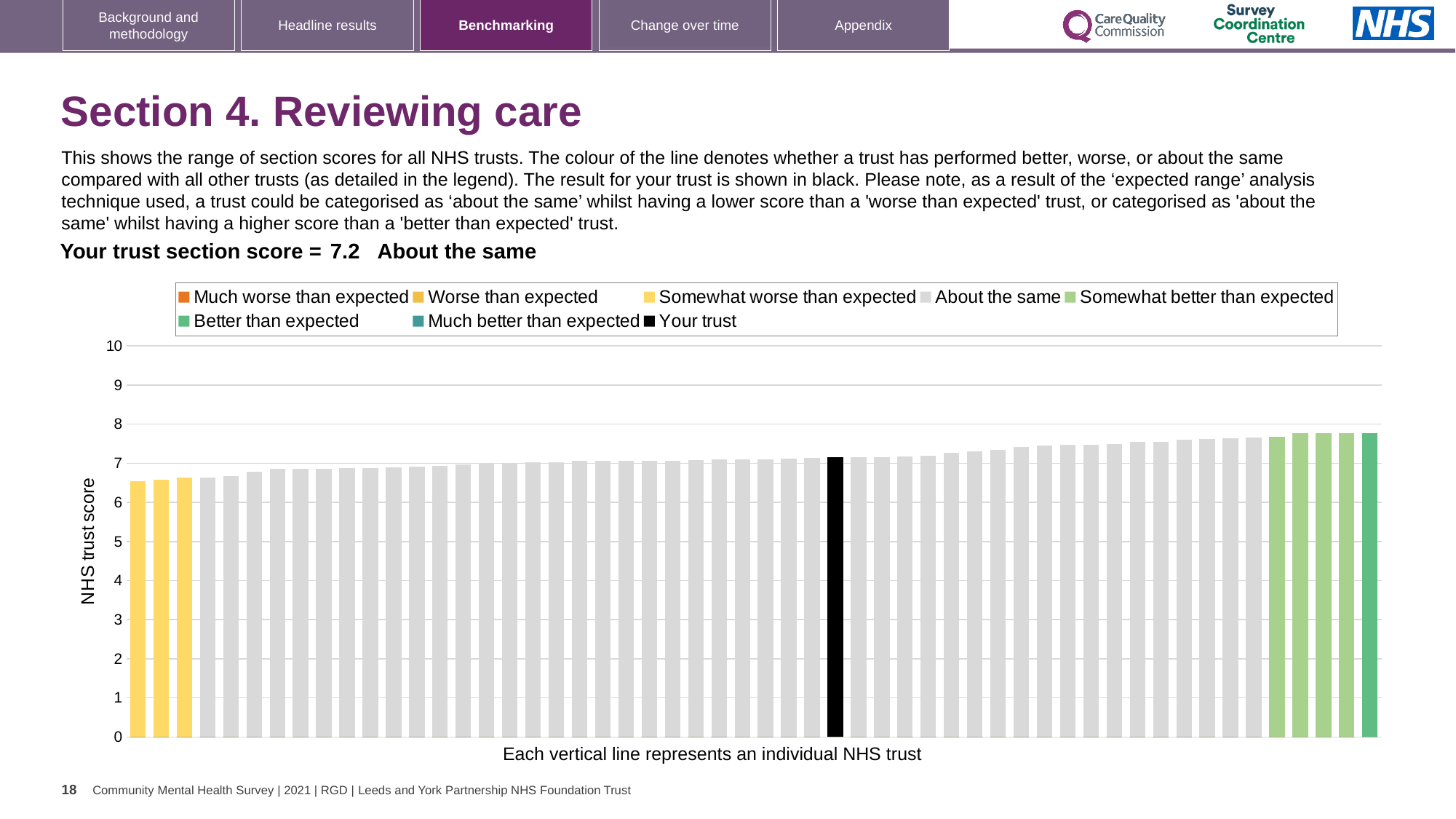
How many bars are coloured light green (Somewhat better than expected)? 4 How many entries does the chart legend list? 8 What is the section score for your trust shown on the slide? 7.2 What kind of chart is shown on the slide? bar chart Is the value of the lowest bar in the chart greater or less than 6? greater Is the value of the highest bar in the chart greater or less than 8? less Do the bar values rise or fall from left to right along the x axis? rise Which category is your trust placed in for this section? About the same Is the value of the black bar (your trust) greater or less than 5? greater How many bars are coloured yellow (Somewhat worse than expected)? 3 What is the label on the vertical axis of the chart? NHS trust score